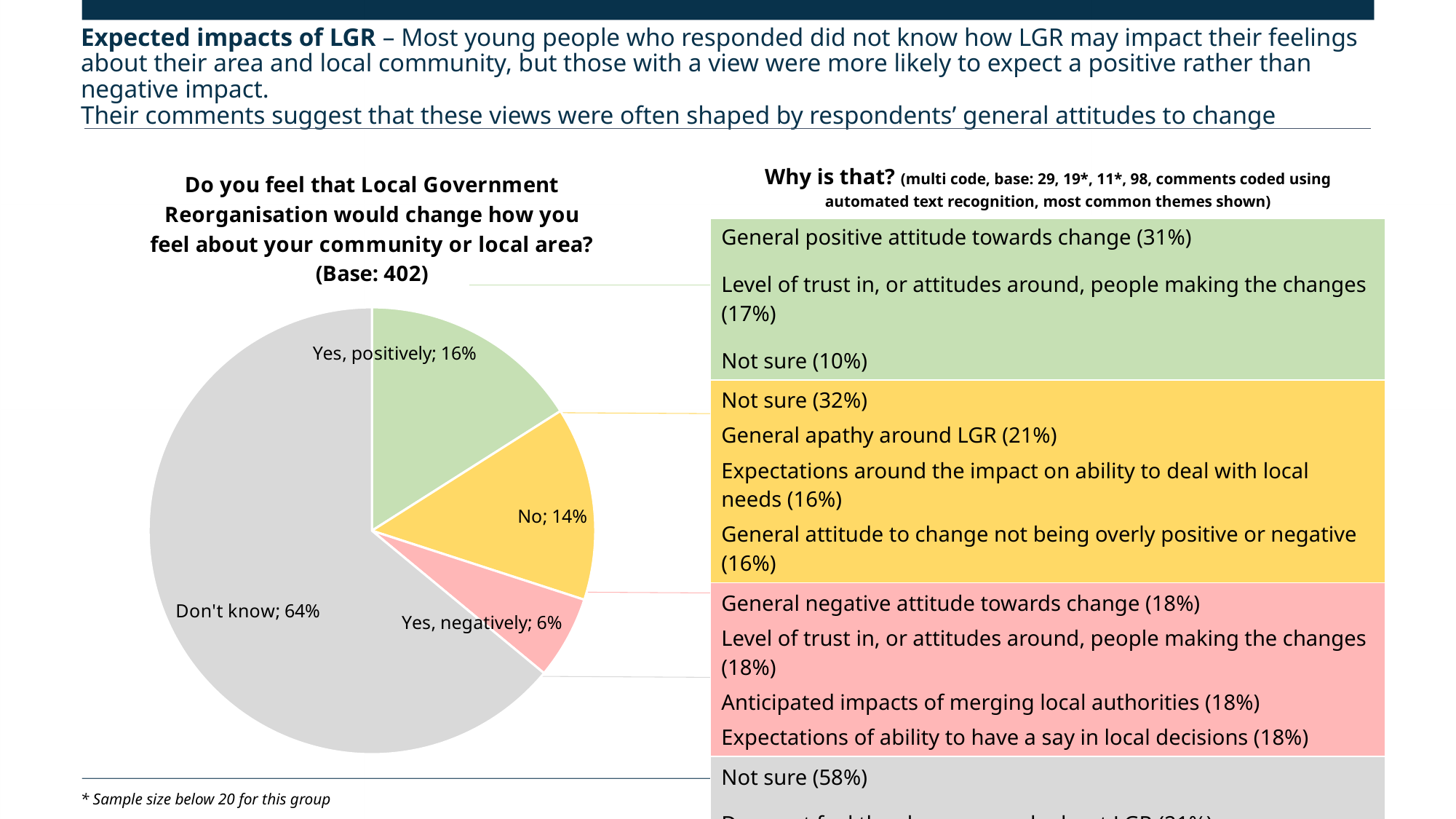
What percentage of respondents answered "Don't know"? 64% What percentage of respondents answered "Yes, positively"? 16% Which is larger: the share for "Yes, positively" or the share for "No"? Yes, positively How many slices does the pie chart have? 4 What percentage of respondents answered "No"? 14% What is the base (number of respondents) stated in the pie chart title? 402 What percentage of respondents answered "Yes, negatively"? 6% Which response has the largest share of the pie? Don't know What colour is the "Don't know" slice of the pie chart? grey What kind of chart is shown on the slide? pie chart Which response has the smallest share of the pie? Yes, negatively What is the difference in percentage points between "Yes, positively" and "Yes, negatively"? 10